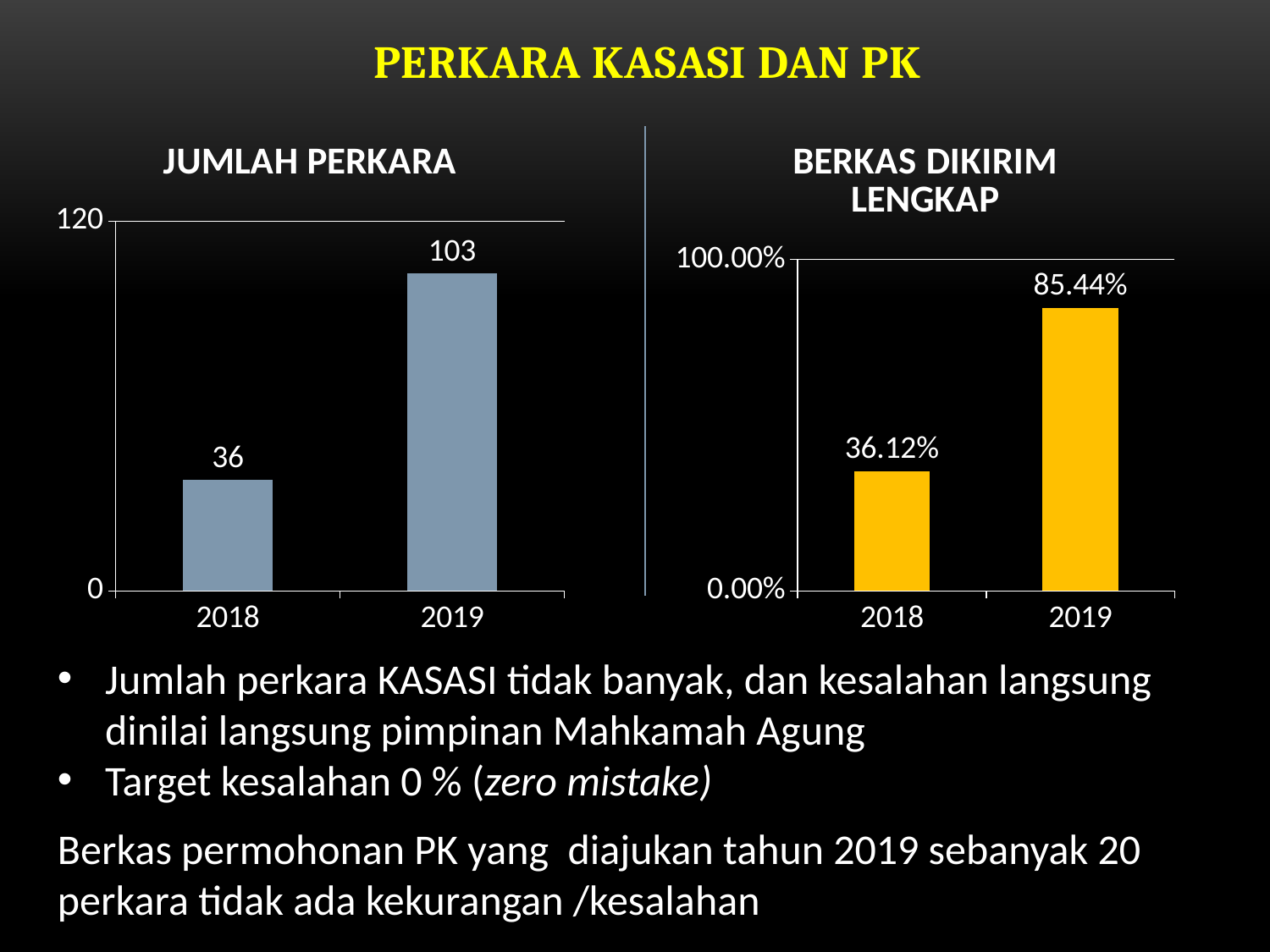
In the JUMLAH PERKARA chart, what is the value for 2018? 36 In the JUMLAH PERKARA chart, what is the value for 2019? 103 In the BERKAS DIKIRIM LENGKAP chart, which year has the lowest value? 2018 In the JUMLAH PERKARA chart, what is the difference between the 2019 and 2018 values? 67 In the JUMLAH PERKARA chart, which is larger, the value for 2018 or 2019? 2019 In the BERKAS DIKIRIM LENGKAP chart, what is the difference between the 2019 and 2018 values? 49.32% What kind of chart is the JUMLAH PERKARA chart? Bar chart In the BERKAS DIKIRIM LENGKAP chart, what is the value for 2019? 85.44% How many categories are shown in the BERKAS DIKIRIM LENGKAP chart? 2 In the BERKAS DIKIRIM LENGKAP chart, do the values rise or fall from 2018 to 2019? Rise In the BERKAS DIKIRIM LENGKAP chart, what is the value for 2018? 36.12% In the JUMLAH PERKARA chart, which year has the highest value? 2019